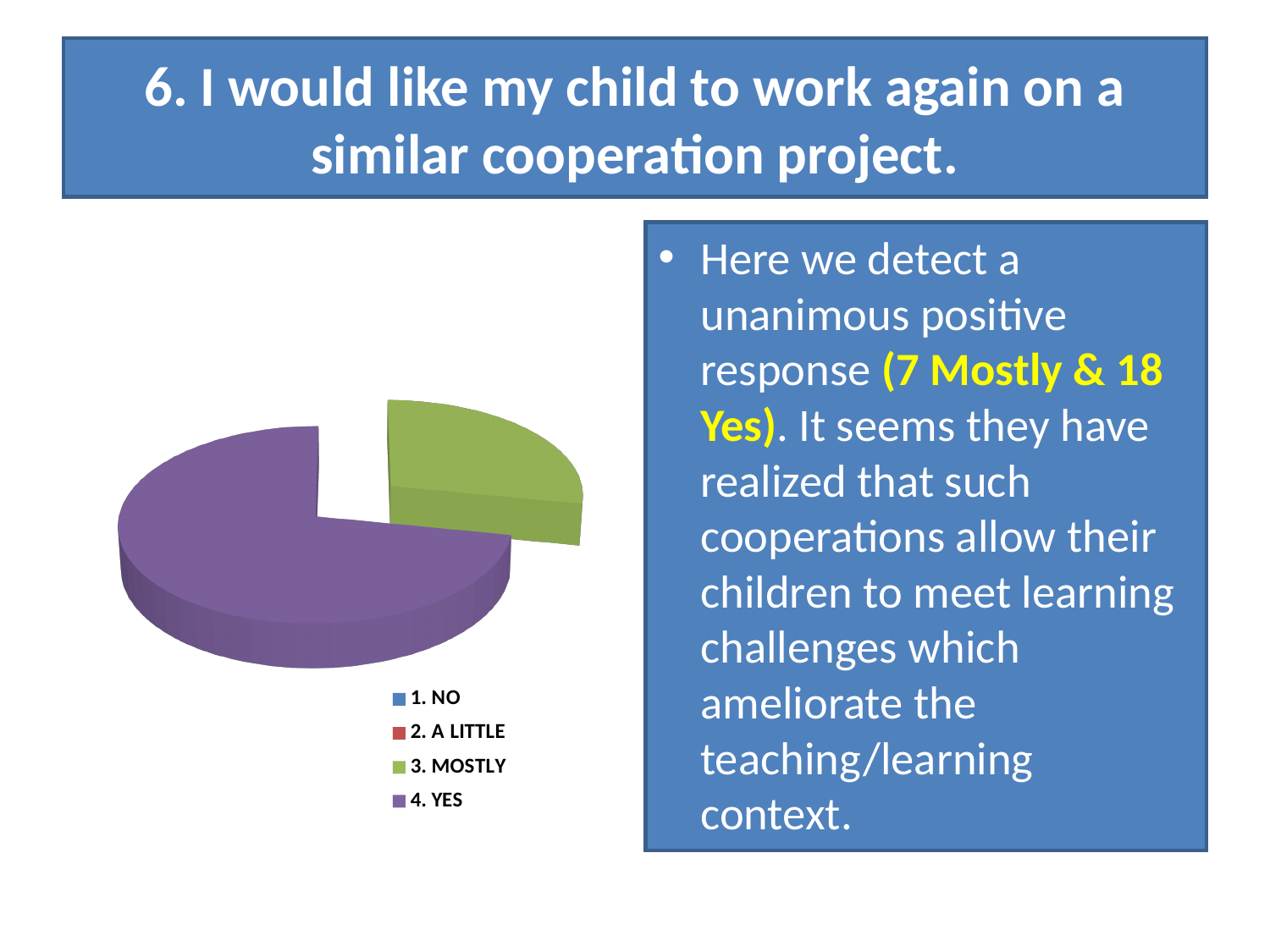
Is the slice for 4. YES larger or smaller than the slice for 3. MOSTLY? larger Which of the two visible slices is smaller, 3. MOSTLY or 4. YES? 3. MOSTLY What colour is the slice for 4. YES? purple How many categories does the legend list? 4 According to the slide, how many responses were 'Mostly'? 7 Which category has the largest slice of the pie? 4. YES How many slices are visible in the pie chart? 2 Which legend entry is shown in green? 3. MOSTLY According to the slide, how many responses were 'Yes'? 18 How many more 'Yes' responses than 'Mostly' responses does the slide report? 11 What kind of chart is shown on the slide? pie chart How many data series does the pie chart show? 1